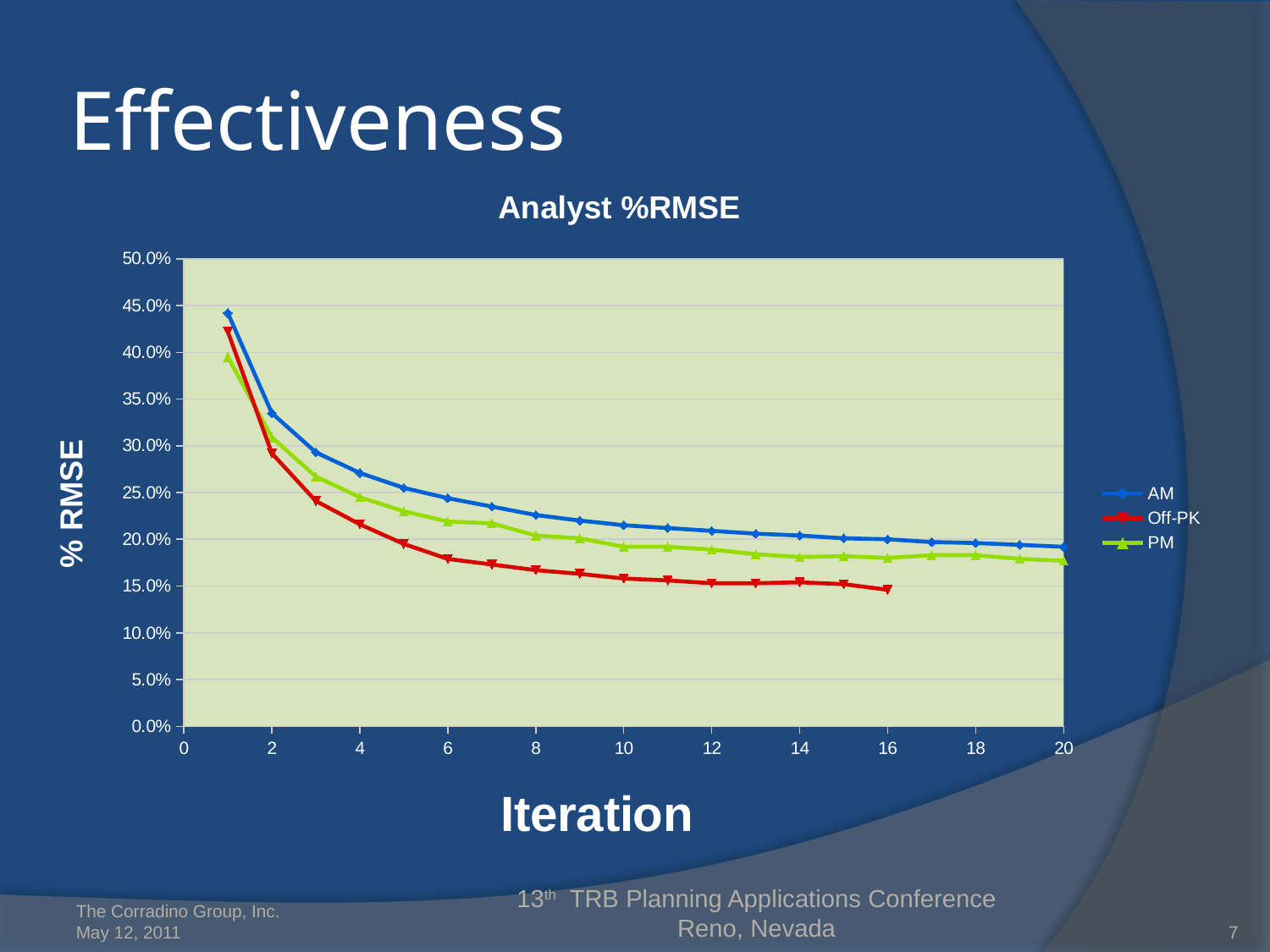
How many series does the legend list? 3 Which series has the lowest % RMSE at iteration 1? PM At iteration 10, which series has the larger % RMSE, AM or Off-PK? AM Is the AM value at iteration 1 greater or less than 40.0%? greater Which series has the highest % RMSE at iteration 1? AM What is the title of the chart? Analyst %RMSE Do the % RMSE values rise or fall as the iteration number increases? fall Is the AM value at iteration 4 greater or less than 25.0%? greater Is the Off-PK value at iteration 10 greater or less than 20.0%? less Which series has the lowest % RMSE across the iterations shown? Off-PK What kind of chart is shown on the slide? line chart What is the label of the x axis? Iteration